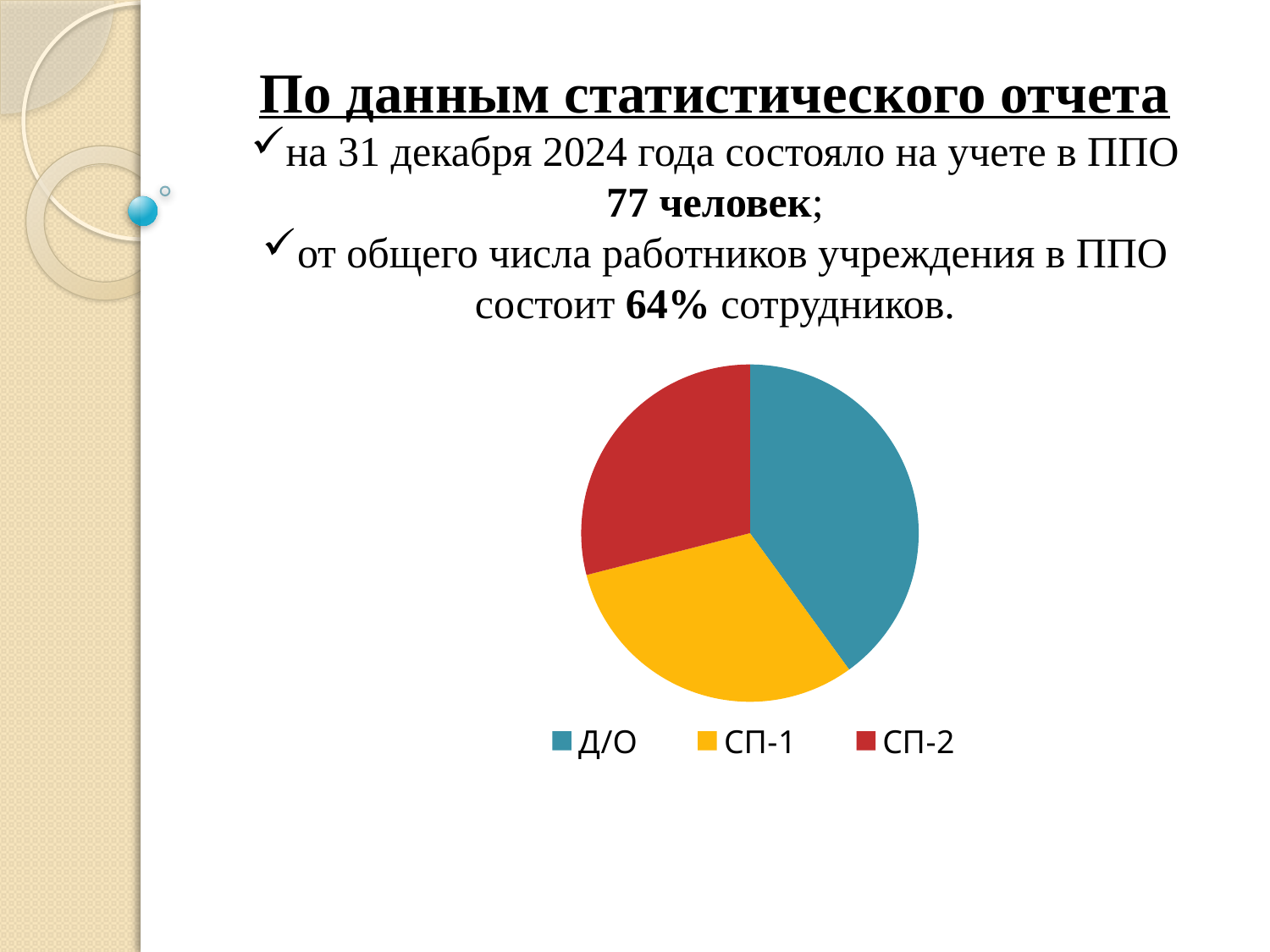
Which category has the largest slice in the pie chart? Д/О What kind of chart is shown on the slide? pie chart How many slices does the pie chart have? 3 Which slice is larger in the pie chart, Д/О or СП-2? Д/О What colour is the Д/О slice in the pie chart? teal Which slice is larger in the pie chart, Д/О or СП-1? Д/О Which category is shown in red in the pie chart? СП-2 How many entries does the legend of the pie chart list? 3